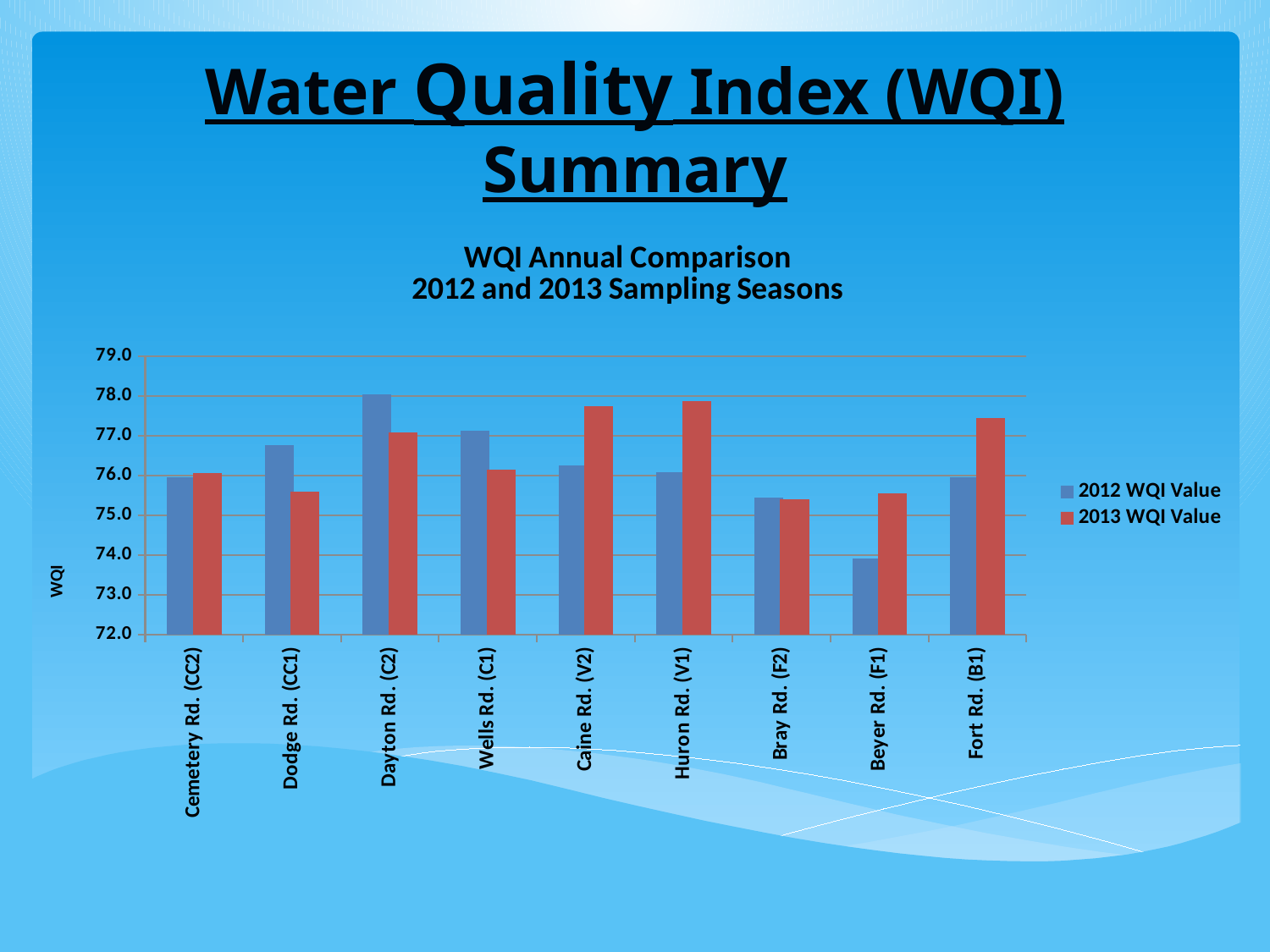
For Beyer Rd. (F1), which is larger: the 2012 WQI Value or the 2013 WQI Value? 2013 WQI Value How many series does the chart's legend list? 2 Which site has the lowest 2012 WQI Value? Beyer Rd. (F1) Which site has the highest 2012 WQI Value? Dayton Rd. (C2) Is the 2013 WQI Value for Caine Rd. (V2) greater or less than 77.0? greater For Dayton Rd. (C2), which is larger: the 2012 WQI Value or the 2013 WQI Value? 2012 WQI Value Is the 2013 WQI Value for Dodge Rd. (CC1) greater or less than 76.0? less Is the 2012 WQI Value for Dayton Rd. (C2) greater or less than 77.0? greater What kind of chart is shown on the slide? Bar chart How many sampling sites are shown along the x axis of the chart? 9 What is the title of the chart? WQI Annual Comparison 2012 and 2013 Sampling Seasons